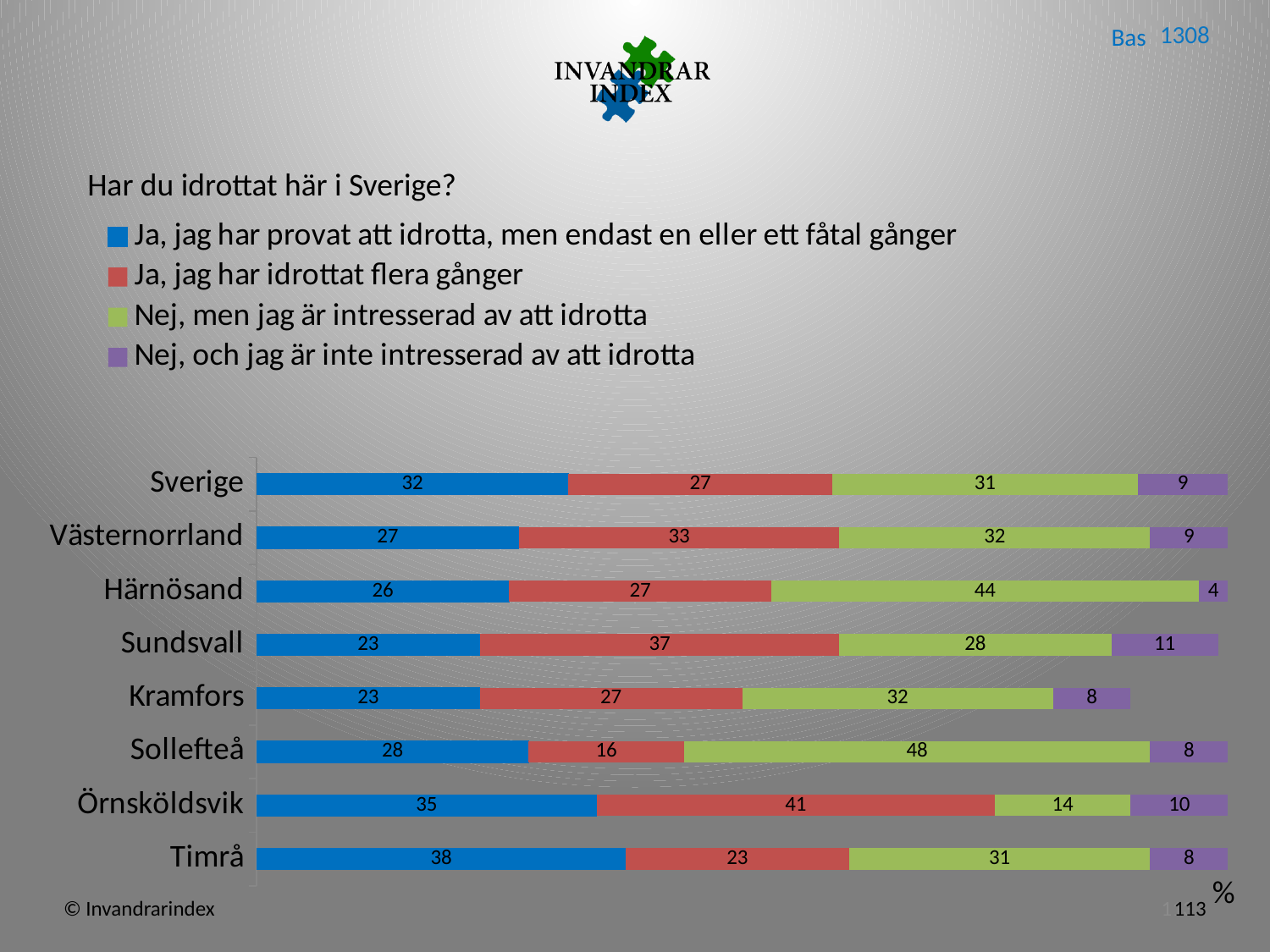
Which category has the lowest value in the series "Nej, och jag är inte intresserad av att idrotta"? Härnösand What is the value for Timrå in the series "Ja, jag har provat att idrotta, men endast en eller ett fåtal gånger"? 38 What is the difference between the "Nej, men jag är intresserad av att idrotta" values for Sollefteå and Örnsköldsvik? 34 What is the value for Örnsköldsvik in the series "Ja, jag har idrottat flera gånger"? 41 What is the total of the stacked bar for Kramfors? 90 How many series does the legend list? 4 Which is larger: the "Ja, jag har provat att idrotta, men endast en eller ett fåtal gånger" value for Sverige or for Västernorrland? Sverige How many categories (regions) are shown on the chart? 8 What is the value for Sollefteå in the series "Nej, men jag är intresserad av att idrotta"? 48 What kind of chart is shown on the slide? Stacked bar chart What is the question shown above the chart? Har du idrottat här i Sverige? Which category has the highest value in the series "Ja, jag har idrottat flera gånger"? Örnsköldsvik